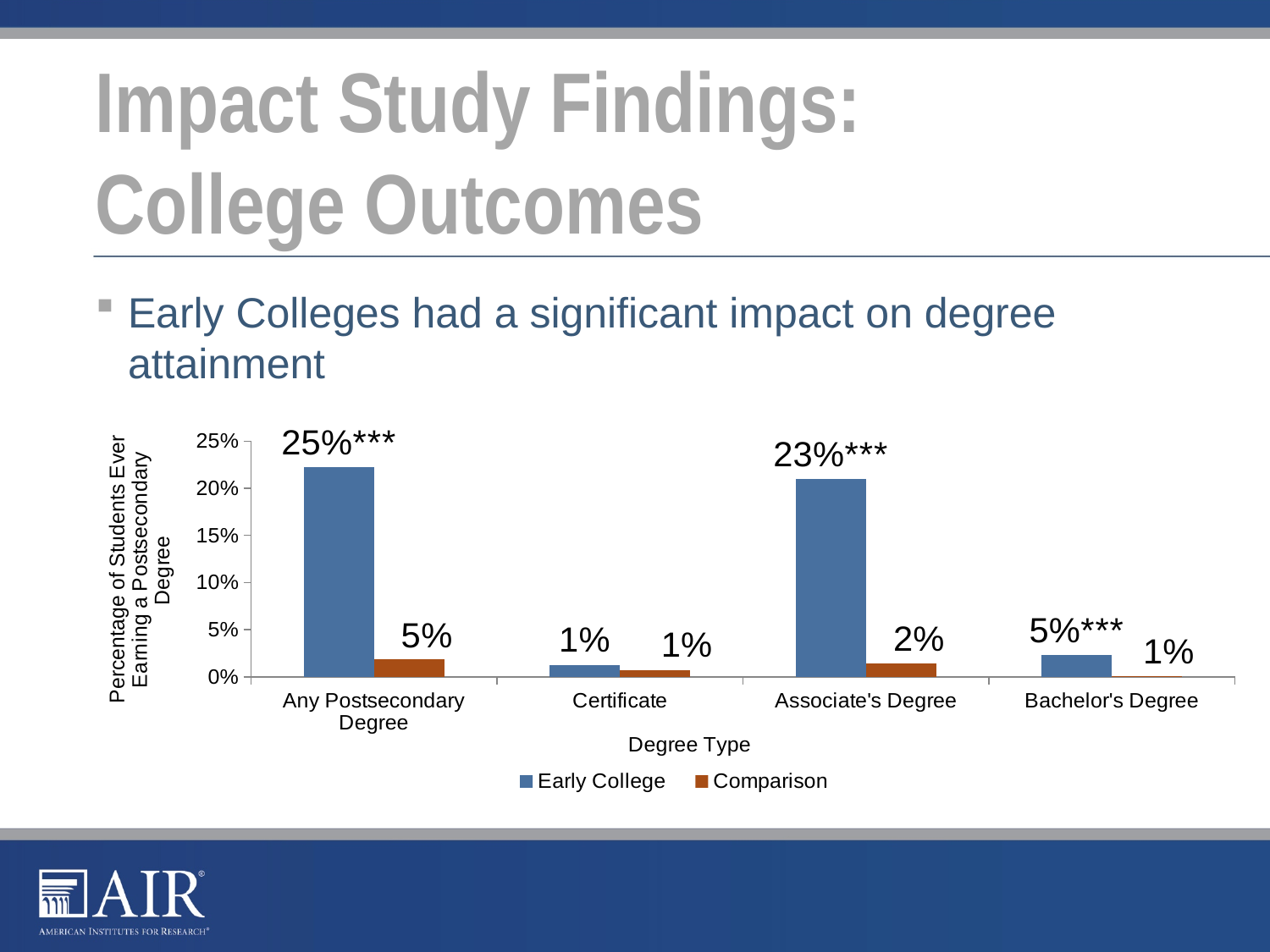
Is the Early College value for Associate's Degree greater or less than 20%? greater What is the Early College value for Any Postsecondary Degree? 25% What is the Comparison value for Any Postsecondary Degree? 5% What is the Comparison value for Associate's Degree? 2% What is the difference between the Early College and Comparison values for Associate's Degree? 21 percentage points What is the Early College value for Bachelor's Degree? 5% Which degree type has the highest Early College value? Any Postsecondary Degree How many series does the legend list? 2 What kind of chart is shown on the slide? bar chart Which is larger for Bachelor's Degree, the Early College value or the Comparison value? Early College How many degree types are shown on the x axis? 4 Which degree type has the lowest Early College value? Certificate